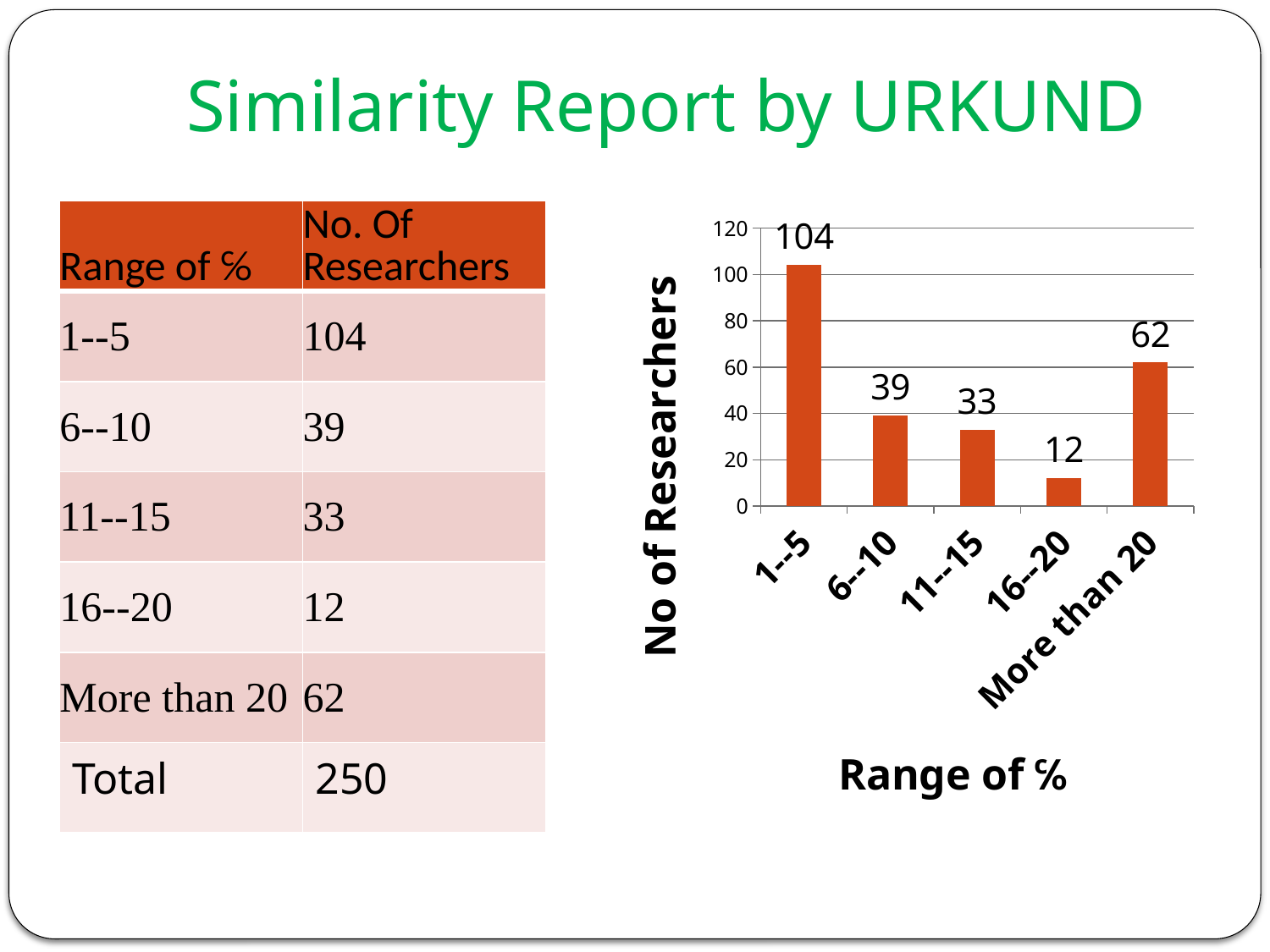
What is the difference between the number of researchers in the 1--5 range and the More than 20 range? 42 What kind of chart is shown on the slide? Bar chart What is the number of researchers for the 1--5 range? 104 Which has more researchers, the 11--15 range or the 16--20 range? 11--15 What is the difference between the number of researchers in the 6--10 range and the 11--15 range? 6 How many ranges are shown on the x axis of the chart? 5 What is the number of researchers for the More than 20 range? 62 Which range has the lowest number of researchers? 16--20 What is the number of researchers for the 6--10 range? 39 What is the label of the chart's y axis? No of Researchers What is the label of the chart's x axis? Range of % Which range has the highest number of researchers? 1--5